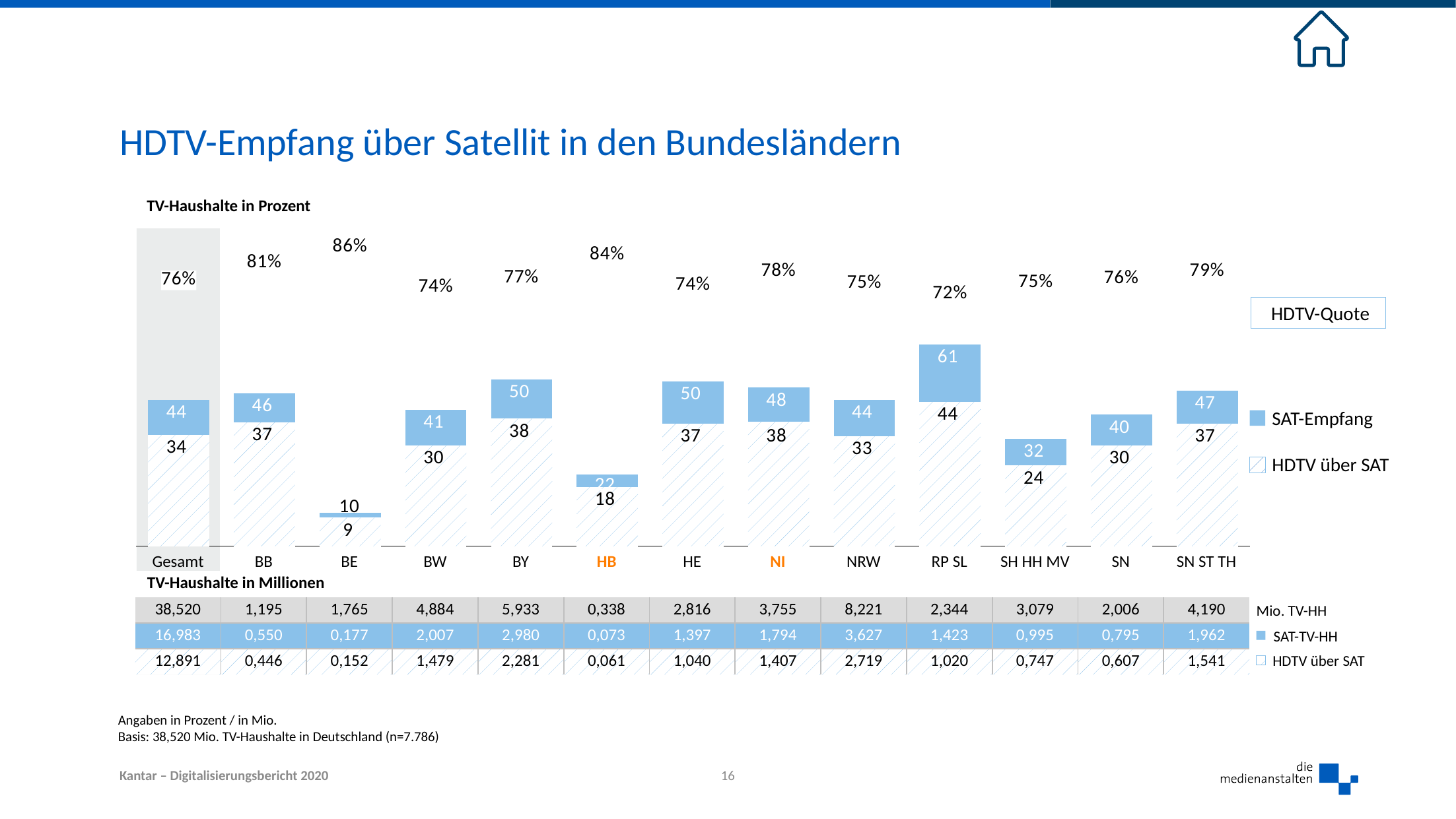
In the table below the chart, what is the Mio. TV-HH value for NRW? 8,221 What is the HDTV über SAT value for BW? 30 How many categories are shown on the x axis of the chart? 13 What is the SAT-Empfang value for RP SL? 61 What kind of chart is shown on the slide? bar chart Which has the larger SAT-Empfang value, NI or NRW? NI Which category has the lowest SAT-Empfang value? BE Which category has the lowest HDTV-Quote? RP SL What is the HDTV-Quote shown for BE? 86% What is the title of the chart on the slide? HDTV-Empfang über Satellit in den Bundesländern Which category has the highest SAT-Empfang value? RP SL What is the difference between the SAT-Empfang value and the HDTV über SAT value for RP SL? 17